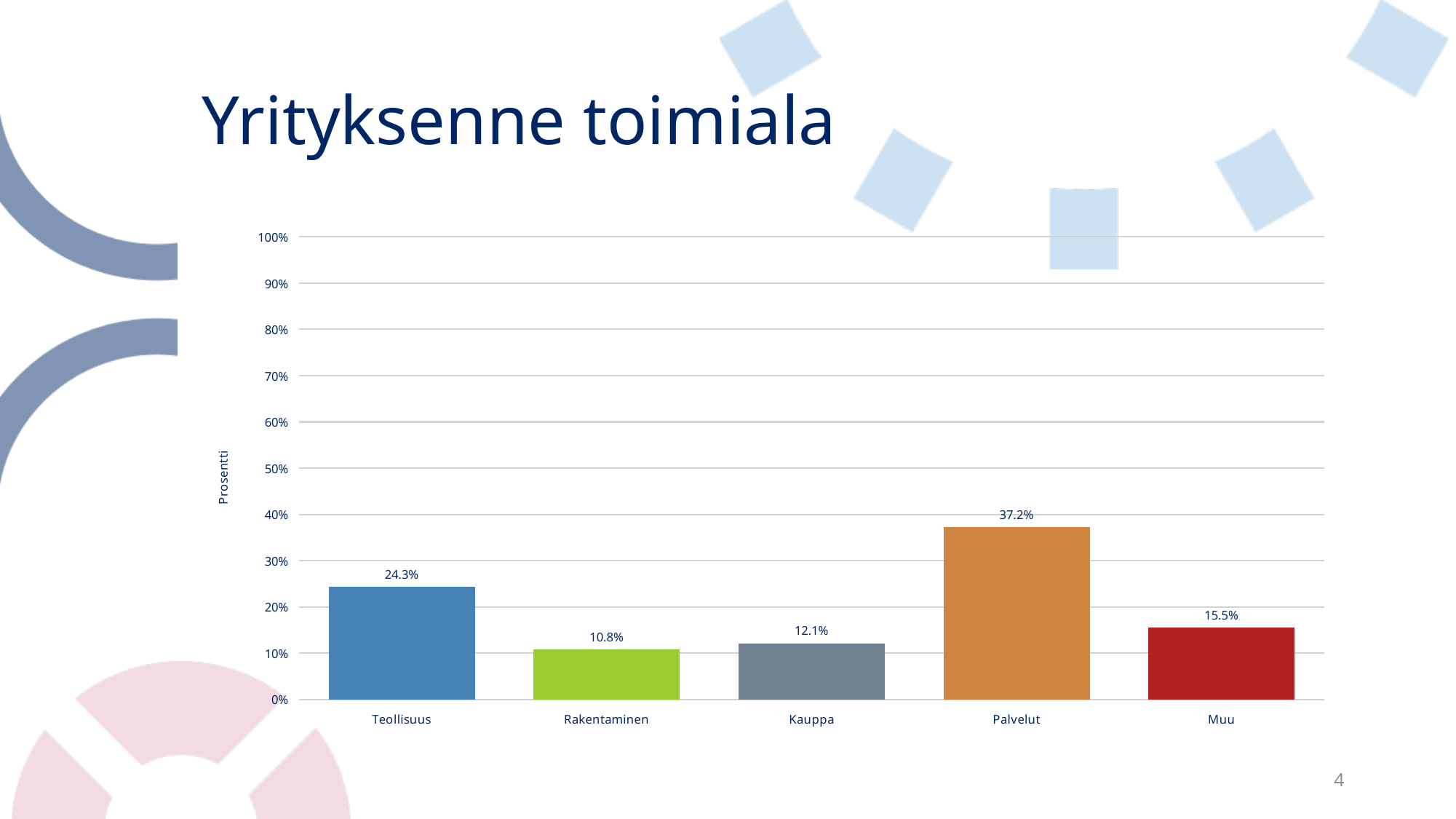
What kind of chart is shown on the slide? bar chart What is the value for Muu? 15.5% What is the value for Teollisuus? 24.3% What is the difference between the values for Palvelut and Teollisuus? 12.9% Which category has the lowest value? Rakentaminen What is the value for Kauppa? 12.1% Which is larger, the value for Muu or the value for Kauppa? Muu How many categories are shown on the x axis? 5 Is the value for Palvelut greater or less than 30%? greater What is the value for Rakentaminen? 10.8% Which category has the highest value? Palvelut What is the value for Palvelut? 37.2%